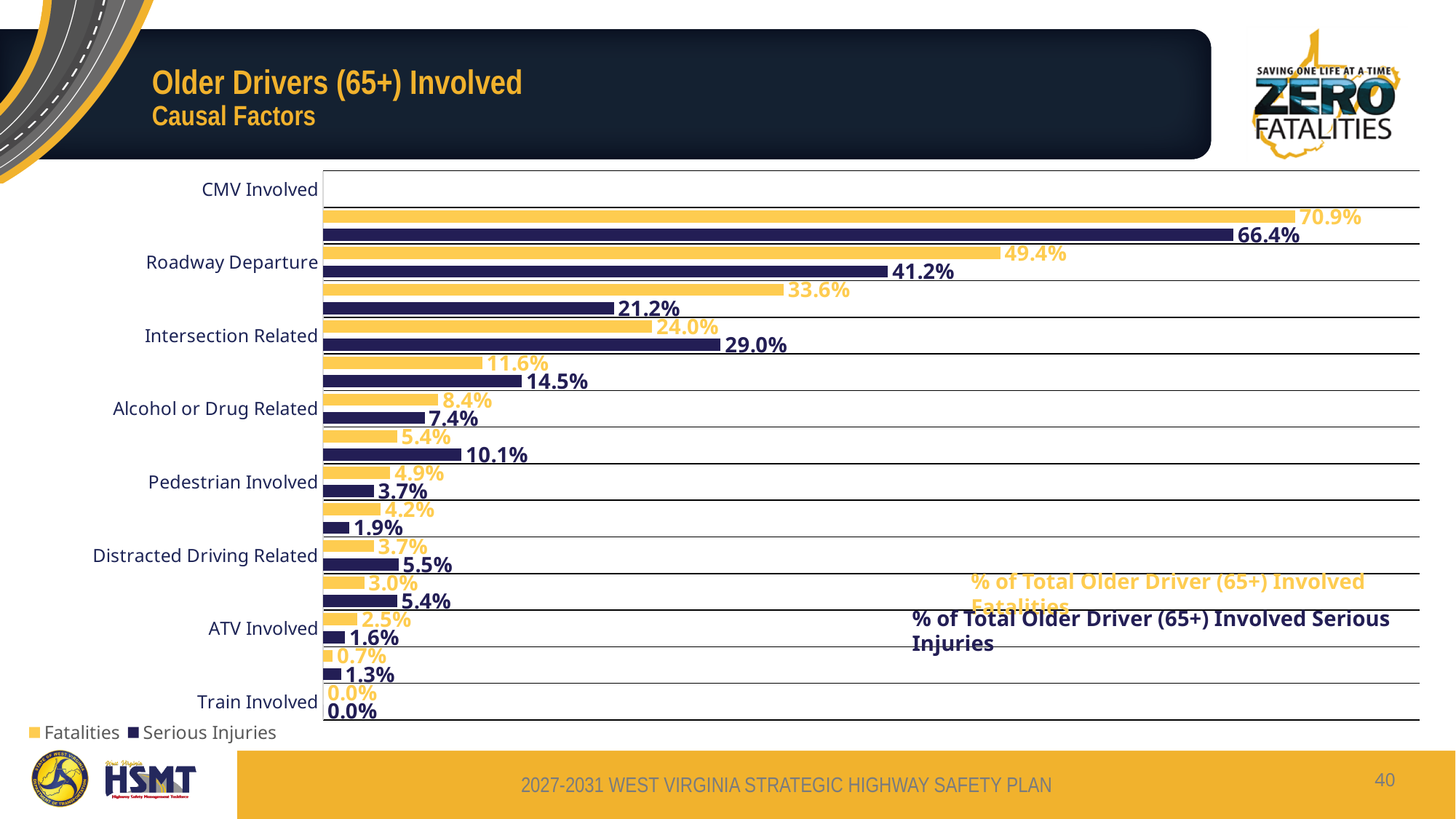
For Intersection Related, which is larger: Fatalities or Serious Injuries? Serious Injuries What is the Fatalities value for Roadway Departure? 49.4% What type of chart is shown on the slide? bar chart How many series does the legend list? 2 What is the difference between the Fatalities and Serious Injuries values for Roadway Departure? 8.2% What is the Serious Injuries value for Roadway Departure? 41.2% What is the Fatalities value for Alcohol or Drug Related? 8.4% What is the Serious Injuries value for Intersection Related? 29.0% What is the Serious Injuries value for Train Involved? 0.0% What is the highest Serious Injuries value shown on the chart? 66.4% What is the highest Fatalities value shown on the chart? 70.9% What are the two series named in the legend? Fatalities and Serious Injuries